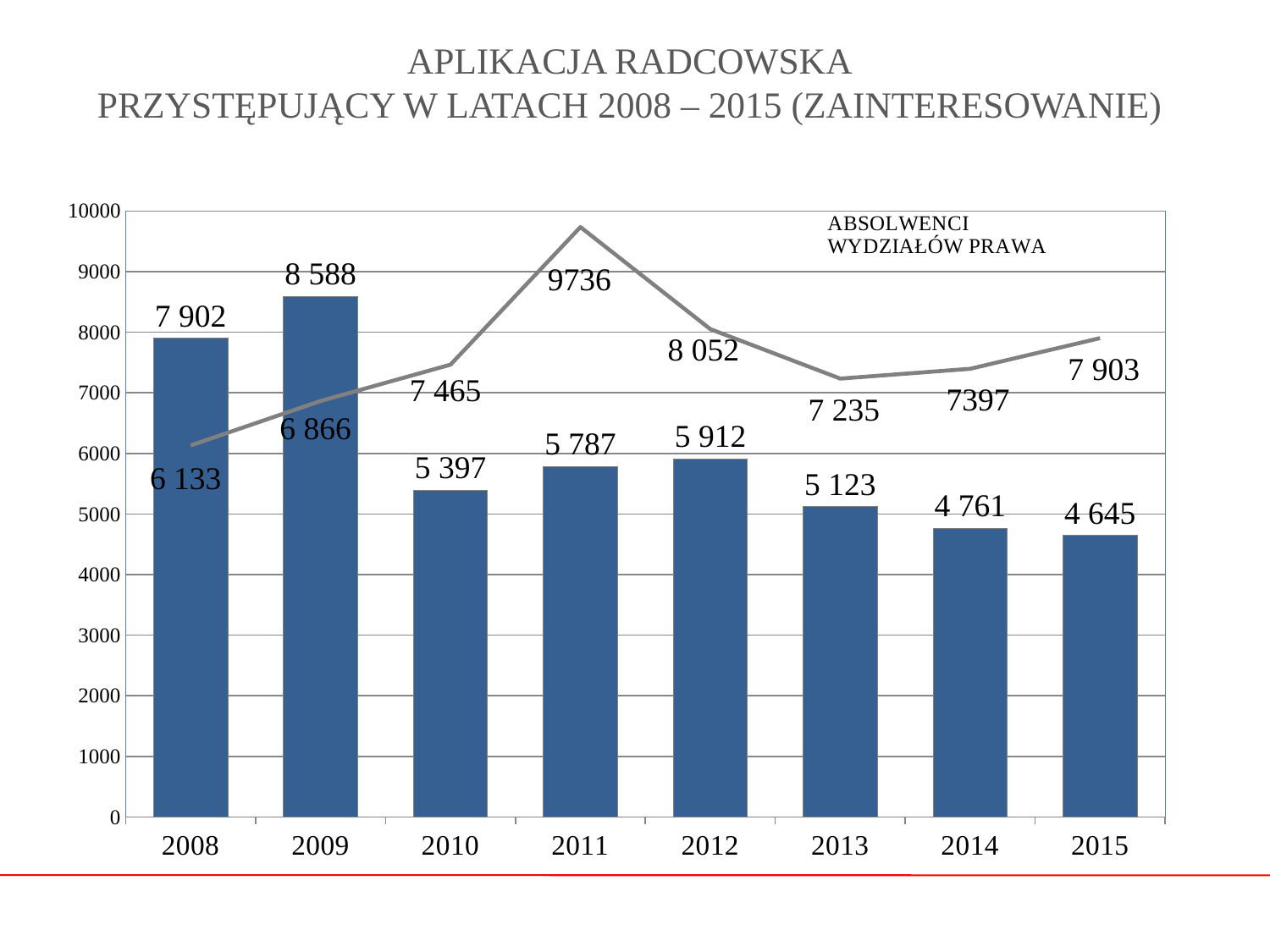
Which is larger, the bar value for 2012 or the bar value for 2013? 2012 Which year has the lowest bar? 2015 How many years are shown on the x axis? 8 What is the value of the bar for 2015? 4 645 Which year has the highest bar? 2009 What is the value of the ABSOLWENCI WYDZIAŁÓW PRAWA line in 2008? 6 133 What kind of chart is shown on the slide? A bar chart combined with a line What is the value of the bar for 2009? 8 588 What is the value of the ABSOLWENCI WYDZIAŁÓW PRAWA line in 2011? 9736 What is the difference between the bar values for 2009 and 2010? 3 191 Do the bar values rise or fall from 2012 to 2015? Fall In which year does the ABSOLWENCI WYDZIAŁÓW PRAWA line reach its highest value? 2011